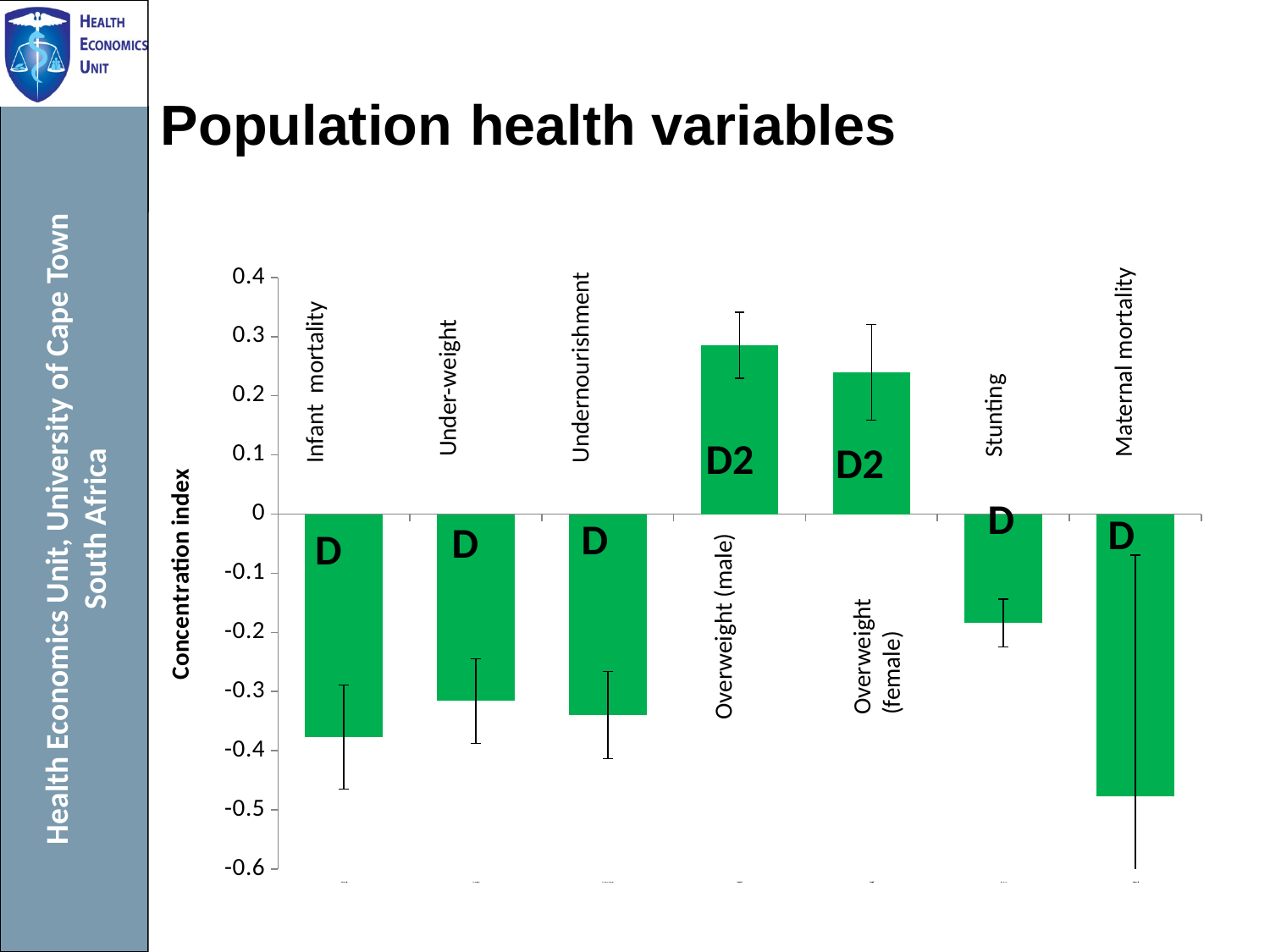
Is the value for Infant mortality greater or less than -0.3? less What is the label on the vertical axis of the chart? Concentration index What kind of chart is shown on the slide? bar chart Is the value for Stunting greater or less than -0.3? greater How many categories are plotted in the chart? 7 Is the value for Overweight (male) greater or less than 0.2? greater Which category has the highest concentration index? Overweight (male) How many categories have a positive concentration index? 2 Which category has the lowest concentration index? Maternal mortality Which has the larger concentration index, Overweight (male) or Overweight (female)? Overweight (male) Which has the larger concentration index, Stunting or Maternal mortality? Stunting